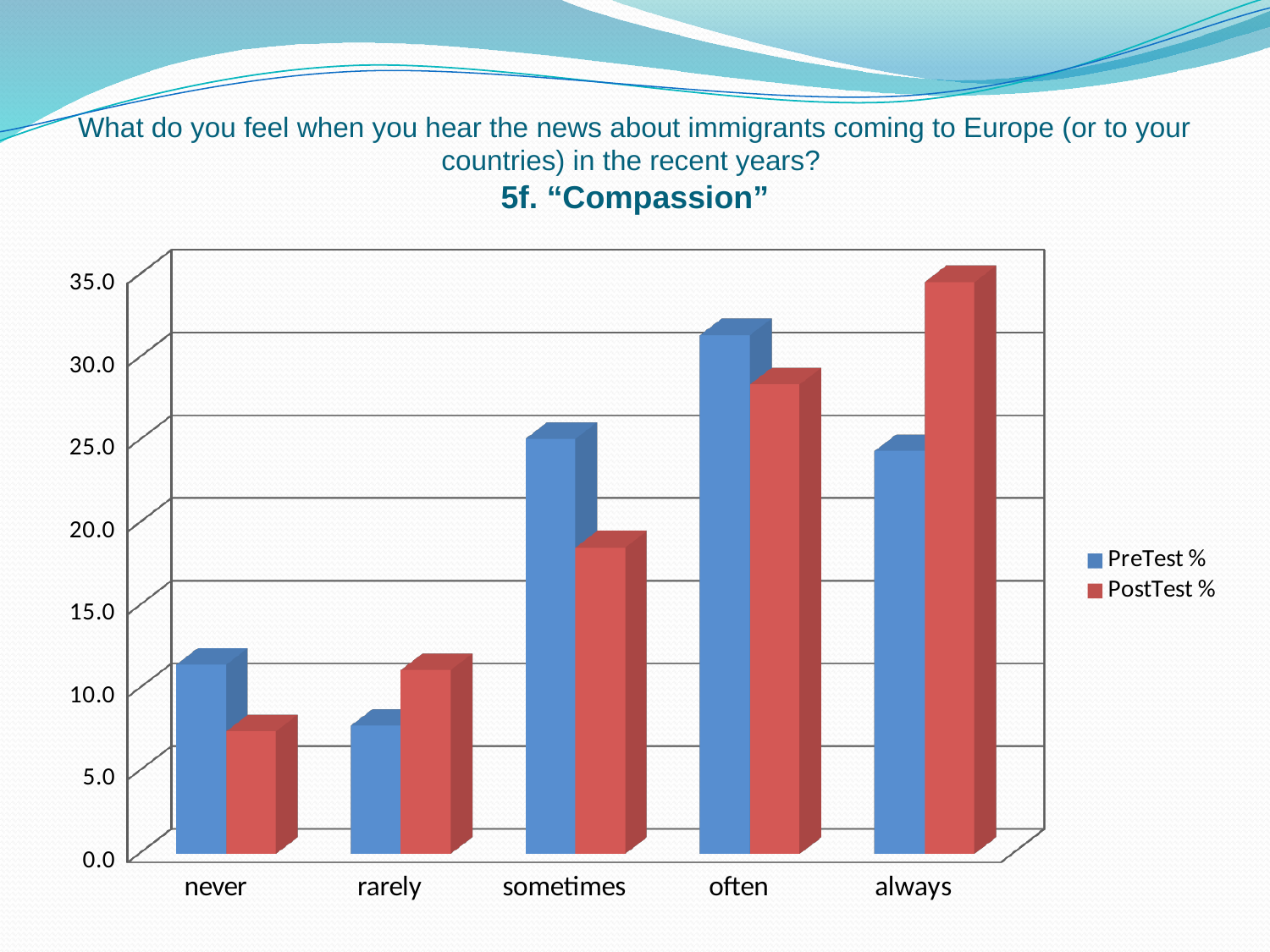
Is the PostTest % value for "always" greater or less than 30? greater Which category has the lowest PostTest % value? never Which category has the highest PostTest % value? always How many categories are shown on the x axis? 5 Which category has the lowest PreTest % value? rarely For the category "always", which is larger: PreTest % or PostTest %? PostTest % For the category "sometimes", which is larger: PreTest % or PostTest %? PreTest % How many series does the legend list? 2 What are the two entries listed in the legend? PreTest % and PostTest % Is the PostTest % value for "never" greater or less than 10? less Which category has the highest PreTest % value? often What kind of chart is shown on the slide? bar chart